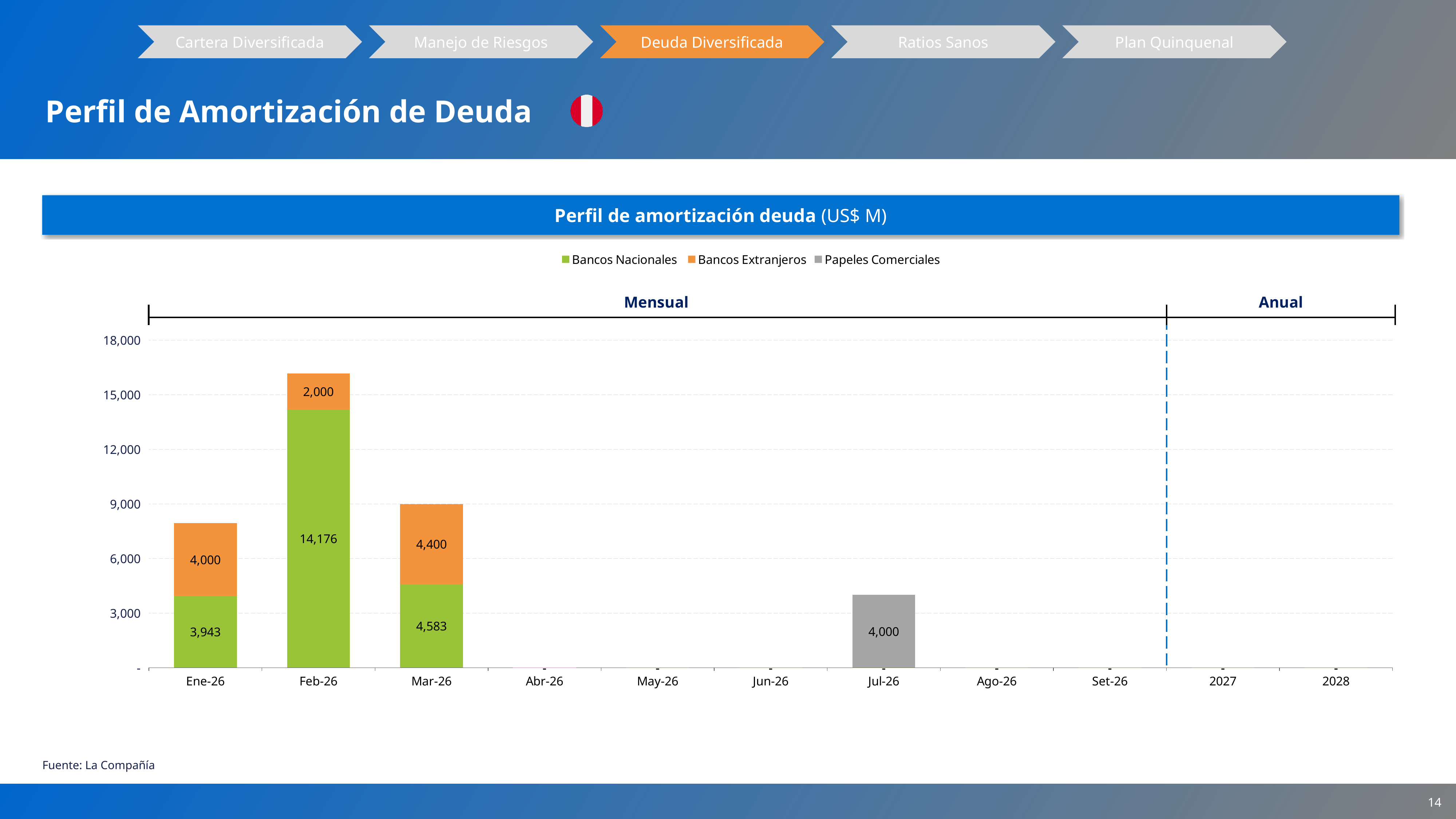
What is the Papeles Comerciales value for Jul-26? 4,000 Which month has the highest total amortization? Feb-26 What type of chart is shown on the slide? Stacked bar chart What is the difference between the Bancos Nacionales values for Mar-26 and Ene-26? 640 What is the Bancos Nacionales value for Feb-26? 14,176 What is the Bancos Nacionales value for Ene-26? 3,943 What is the total of the stacked bar for Feb-26? 16,176 What is the Bancos Extranjeros value for Mar-26? 4,400 Which is larger, the Bancos Extranjeros value for Ene-26 or for Feb-26? Ene-26 How many categories are shown on the x axis? 11 What is the total of the stacked bar for Ene-26? 7,943 How many series does the legend list? 3